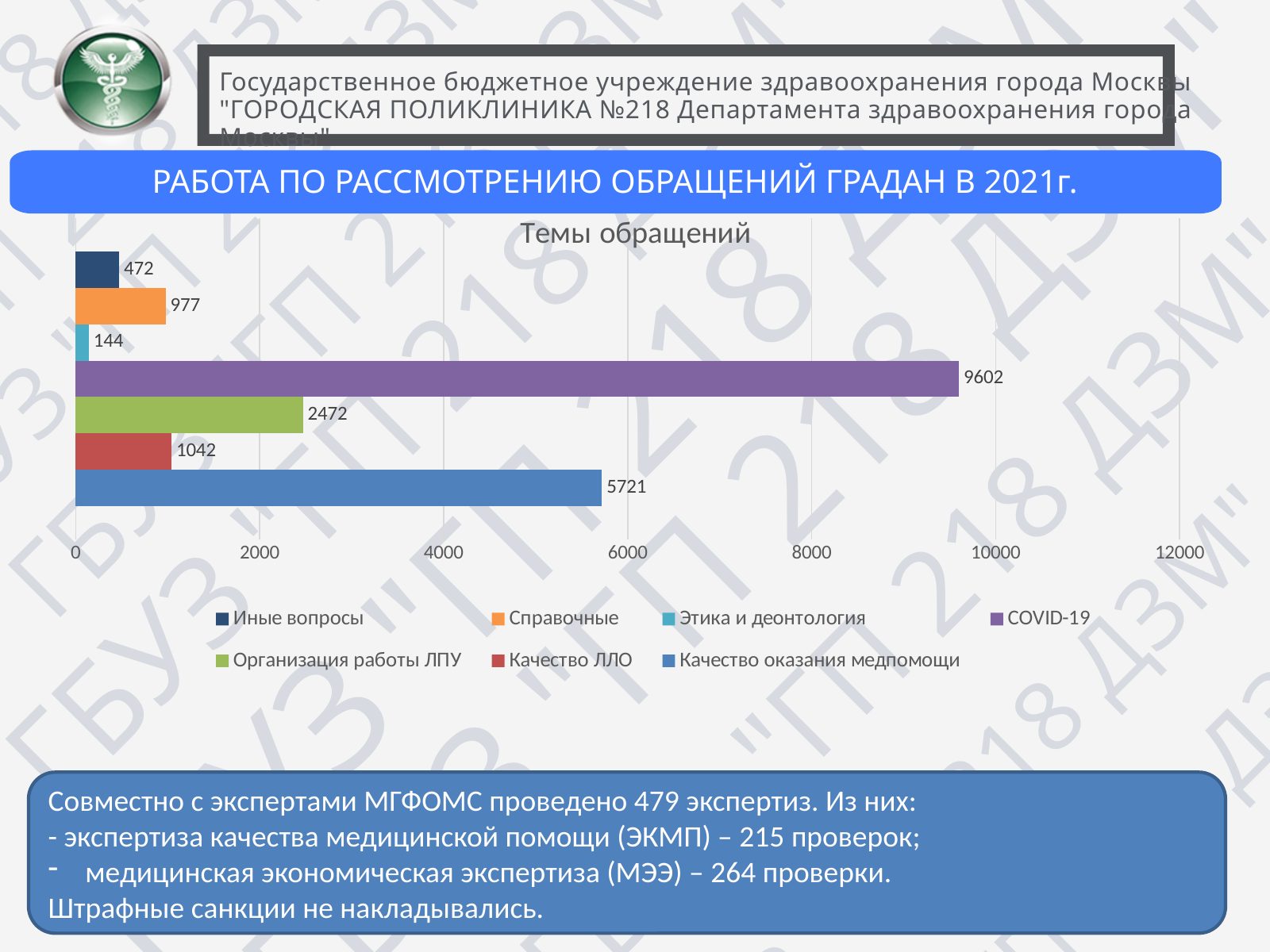
Which category has the lowest value in the 'Темы обращений' chart? Этика и деонтология What is the difference between the values for COVID-19 and 'Качество оказания медпомощи' in the 'Темы обращений' chart? 3881 What is the value for 'Качество оказания медпомощи' in the 'Темы обращений' chart? 5721 Which is larger in the 'Темы обращений' chart: 'Справочные' or 'Качество ЛЛО'? Качество ЛЛО What type of chart is 'Темы обращений'? bar chart Is the value for 'Организация работы ЛПУ' in the 'Темы обращений' chart greater or less than 2000? greater What colour is the bar for COVID-19 in the 'Темы обращений' chart? purple Which category has the highest value in the 'Темы обращений' chart? COVID-19 How many categories are shown in the 'Темы обращений' chart? 7 What is the value for 'Этика и деонтология' in the 'Темы обращений' chart? 144 What is the value for 'Организация работы ЛПУ' in the 'Темы обращений' chart? 2472 What is the value for COVID-19 in the 'Темы обращений' chart? 9602